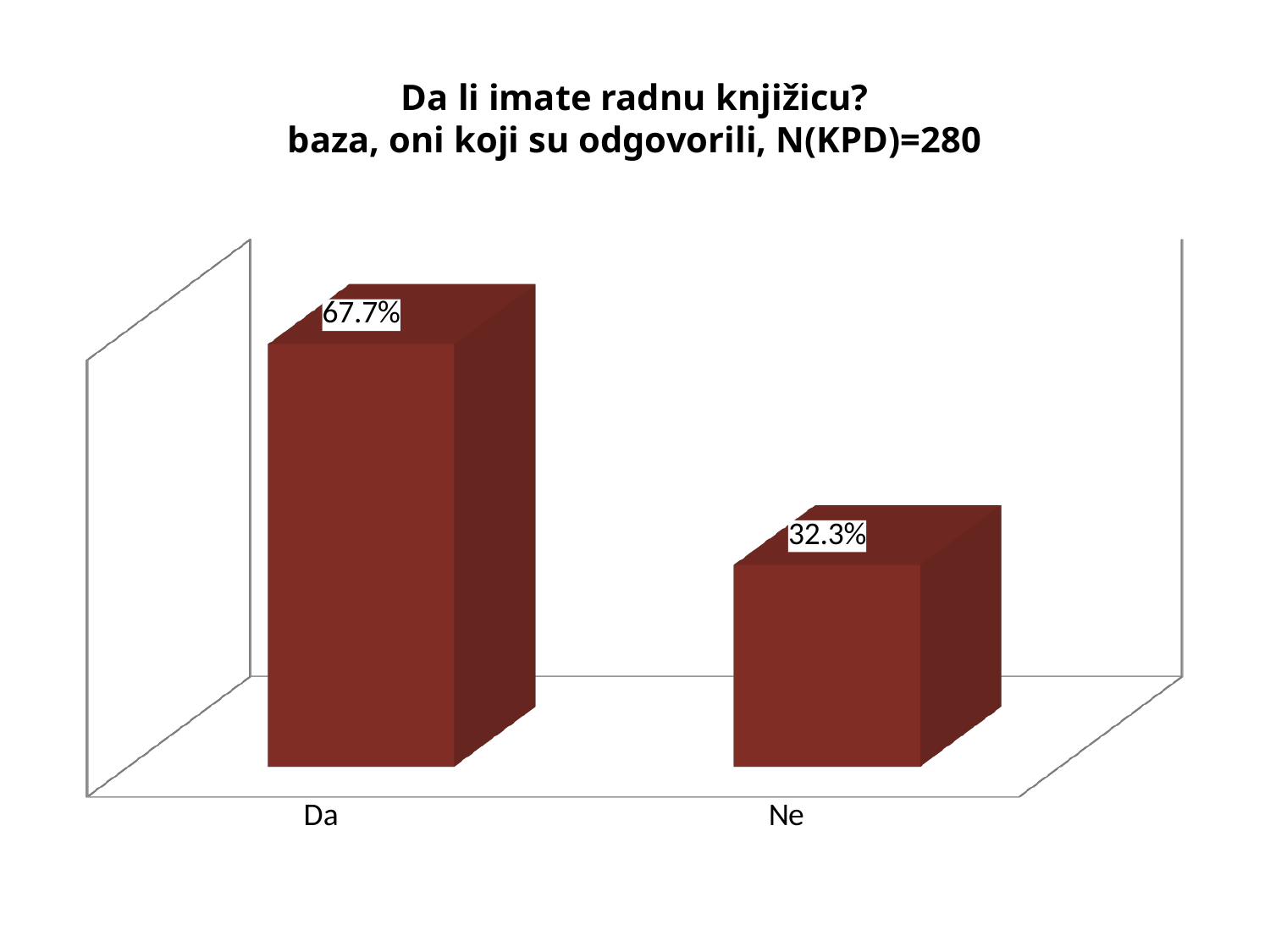
Which category has the highest value? Da Do the values rise or fall from Da to Ne? Fall What is the base size N(KPD) stated in the chart title? 280 What is the value for Ne? 32.3% What is the value for Da? 67.7% Which is larger, the value for Da or the value for Ne? Da Which category has the lowest value? Ne How many categories are shown on the chart? 2 What kind of chart is shown on the slide? Bar chart What is the total of the two values shown? 100% What is the difference between the values for Da and Ne? 35.4% What is the title of the chart? Da li imate radnu knjižicu? baza, oni koji su odgovorili, N(KPD)=280